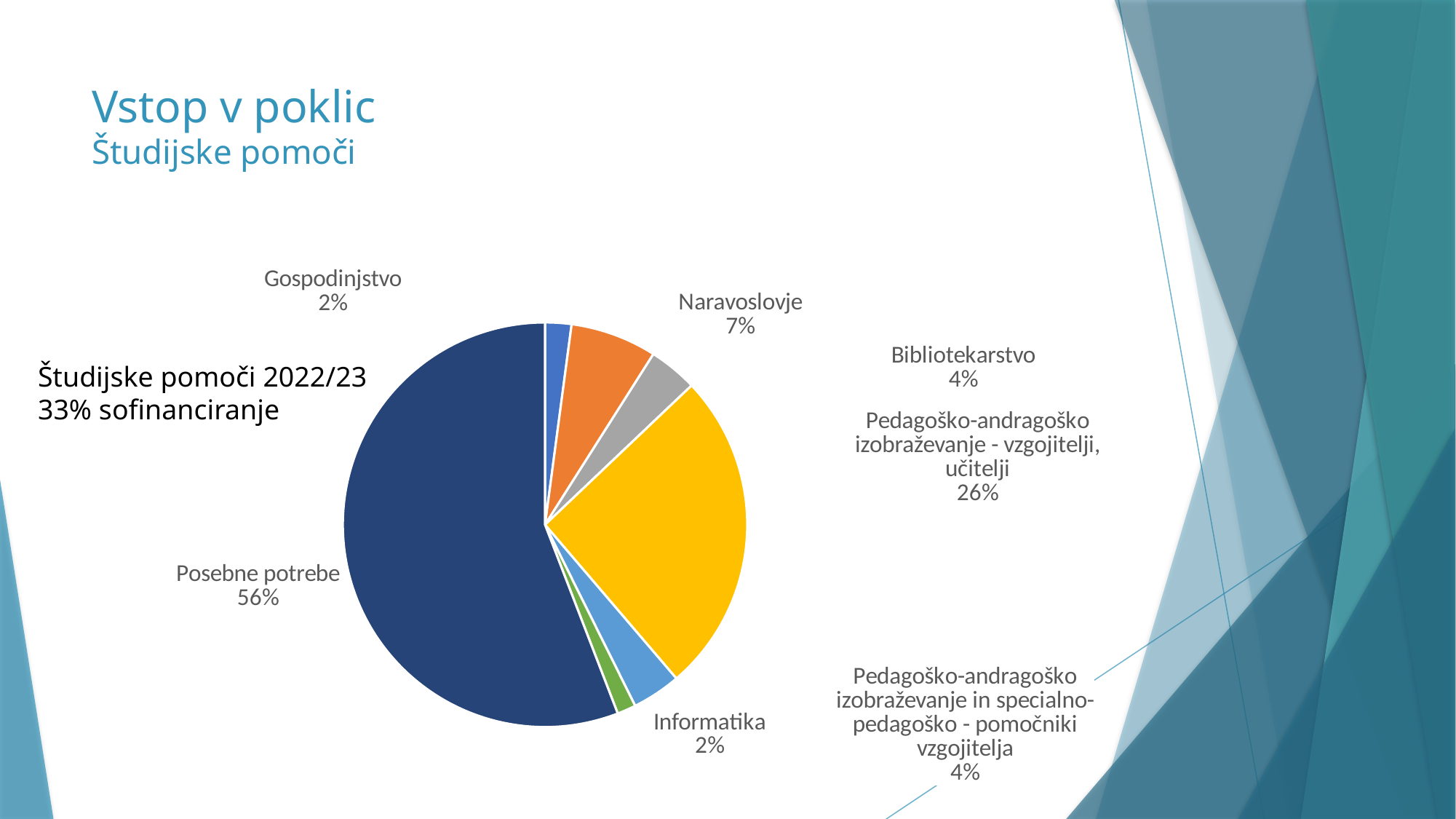
What percentage is shown for Naravoslovje? 7% What is the difference in percentage points between Posebne potrebe and Pedagoško-andragoško izobraževanje - vzgojitelji, učitelji? 30 What kind of chart is shown on the slide? Pie chart What colour is the Posebne potrebe slice? Dark blue What share of the pie does Posebne potrebe hold? 56% What percentage is shown for Gospodinjstvo? 2% Which category has the largest slice of the pie? Posebne potrebe How many slices does the pie chart have? 7 What percentage is shown for Pedagoško-andragoško izobraževanje - vzgojitelji, učitelji? 26% Which category has the larger share, Naravoslovje or Bibliotekarstvo? Naravoslovje What percentage is shown for Bibliotekarstvo? 4% What percentage is shown for Informatika? 2%